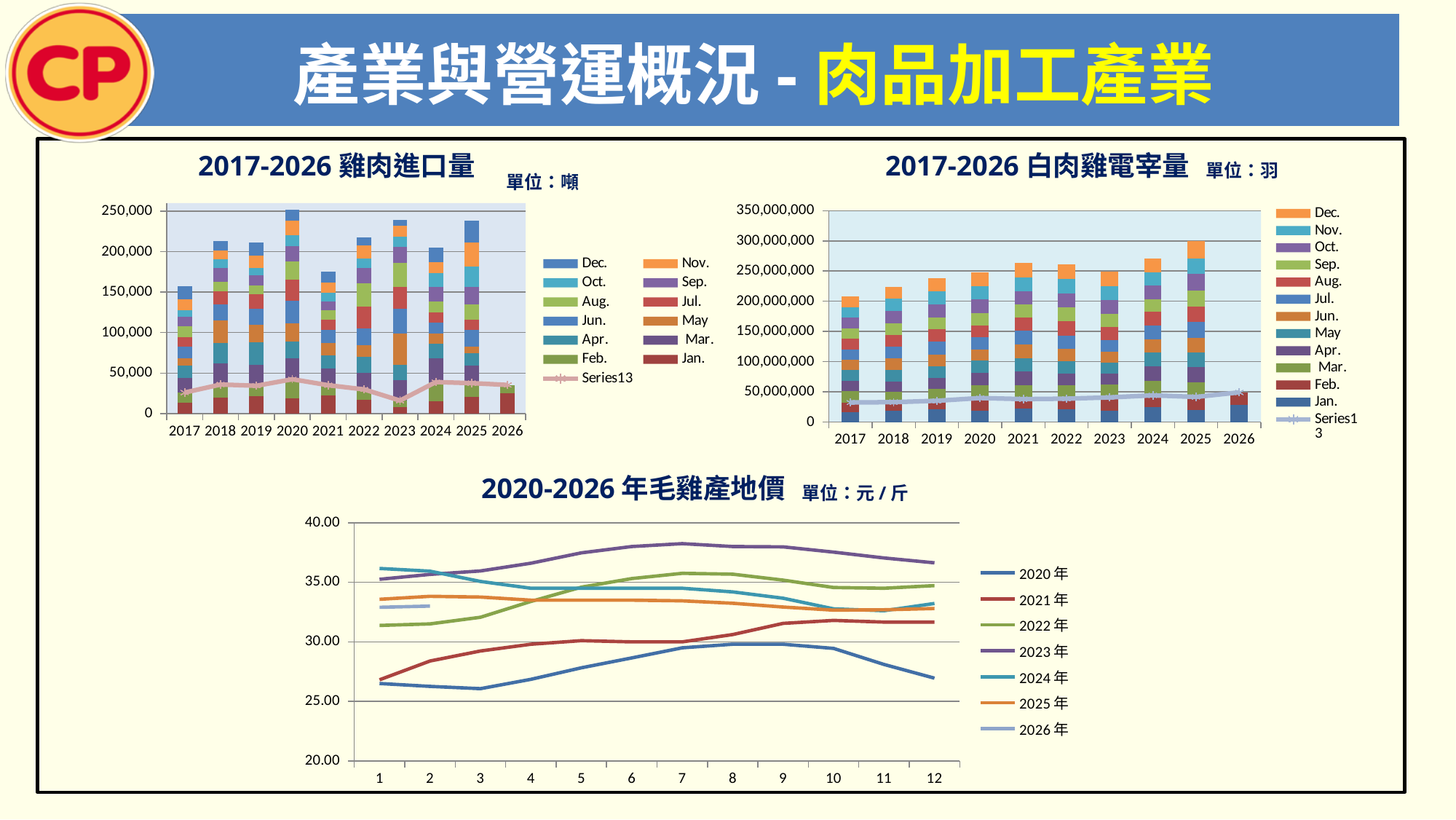
In the "2020-2026 年毛雞產地價" chart, is the value for 2020 年 at month 3 greater or less than 30.00? less What kind of chart is the "2017-2026 雞肉進口量" chart? Stacked bar chart In the "2017-2026 白肉雞電宰量" chart, which year has the highest total bar? 2025 What unit is stated for the "2017-2026 雞肉進口量" chart? 噸 How many series does the legend of the "2020-2026 年毛雞產地價" chart list? 7 In the "2017-2026 白肉雞電宰量" chart, is the total for 2018 greater or less than 250,000,000? less In the "2020-2026 年毛雞產地價" chart, which year's line is highest at month 7? 2023 年 What kind of chart is the "2020-2026 年毛雞產地價" chart? Line chart In the "2017-2026 白肉雞電宰量" chart, is the total for 2017 greater or less than 200,000,000? greater In the "2017-2026 雞肉進口量" chart, which year has the highest total bar? 2020 How many years are shown on the x axis of the "2017-2026 雞肉進口量" chart? 10